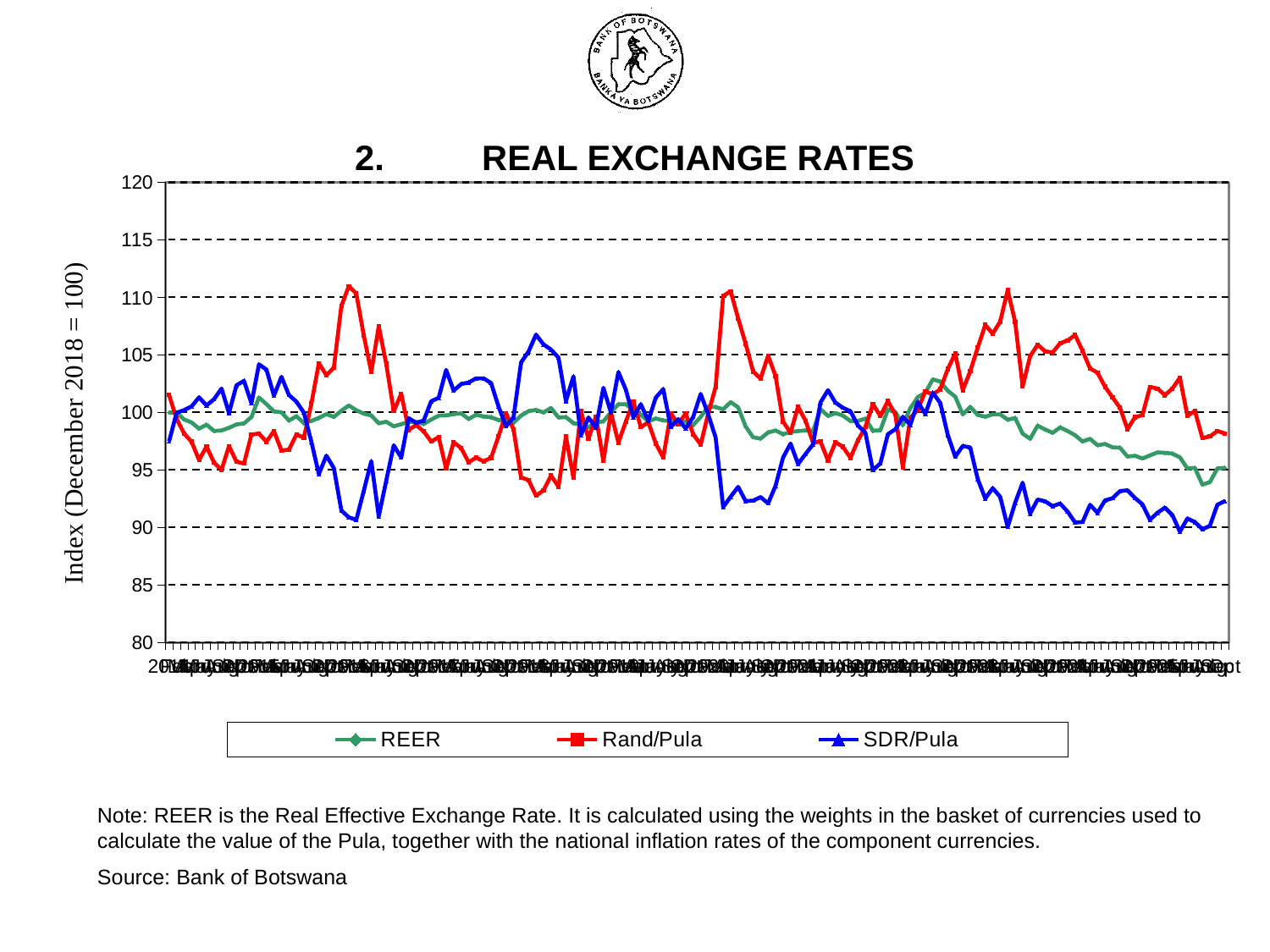
What kind of chart is shown on the slide? Line chart Does the REER series rise or fall over the final third of the chart? fall Is the lowest value reached by the SDR/Pula series greater or less than 95? less Is the highest value reached by the Rand/Pula series greater or less than 105? greater What is the title of the chart? REAL EXCHANGE RATES Which series reaches the highest value anywhere on the chart? Rand/Pula What is the label on the vertical axis of the chart? Index (December 2018 = 100) Does the SDR/Pula series end higher or lower than it starts? lower Which series reaches the lowest value anywhere on the chart? SDR/Pula Is the final value of the REER series greater or less than 100? less At the right-hand end of the chart, which is higher, Rand/Pula or SDR/Pula? Rand/Pula How many series does the legend list? 3